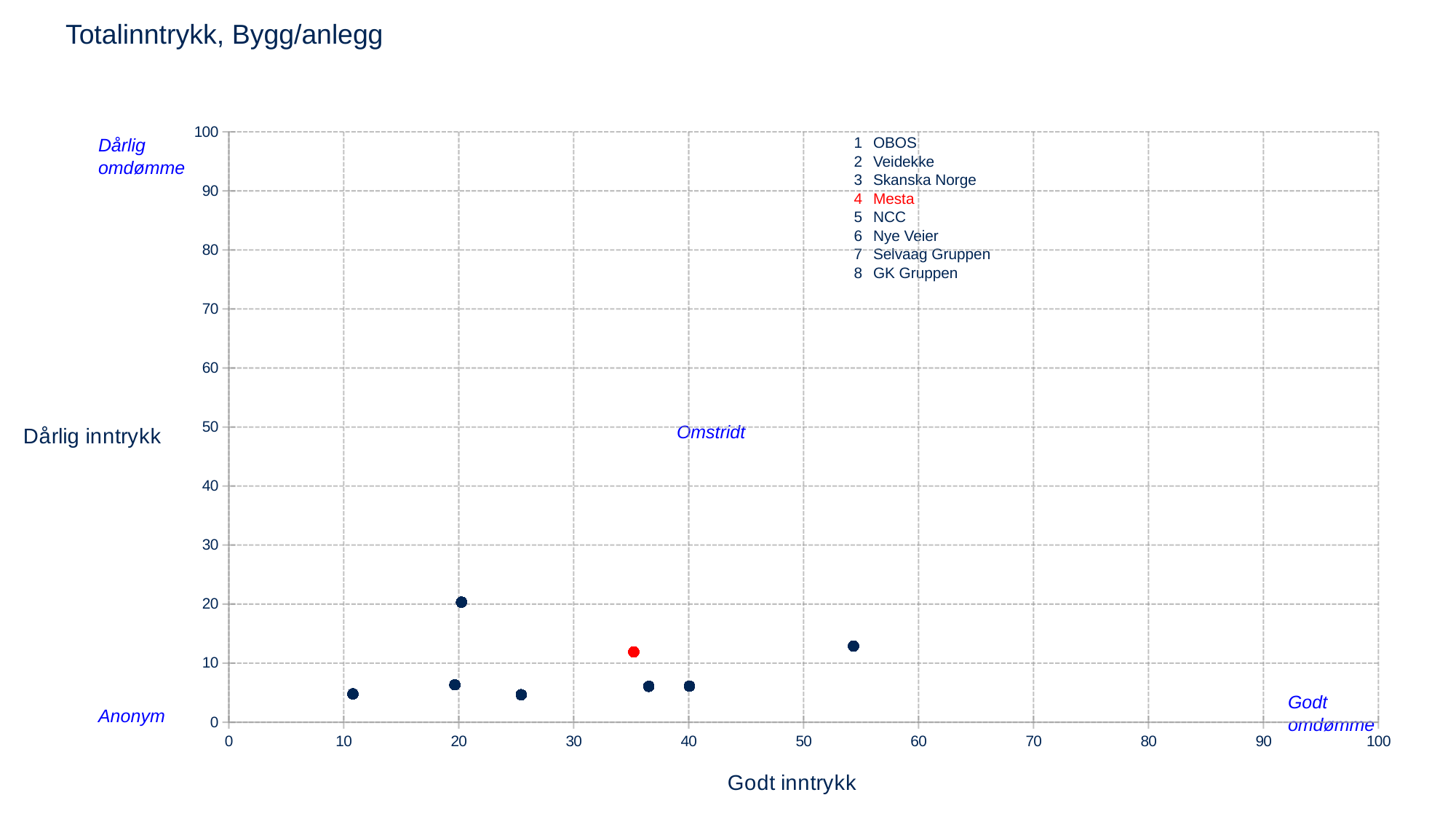
Is the Godt inntrykk (x-axis) value of the leftmost point greater or less than 20? less Is the Godt inntrykk (x-axis) value of the rightmost point greater or less than 50? greater Which company is highlighted in red in the legend and plotted as the red point? Mesta Which has the larger Godt inntrykk (x-axis) value: the red Mesta point or the rightmost dark point? the rightmost dark point Is the Dårlig inntrykk (y-axis) value of the highest point greater or less than 30? less How many companies does the legend list? 8 What is the title of the chart? Totalinntrykk, Bygg/anlegg How many data points are plotted on the chart? 8 What kind of chart is shown on the slide? scatter chart How many points have a Godt inntrykk (x-axis) value greater than 50? 1